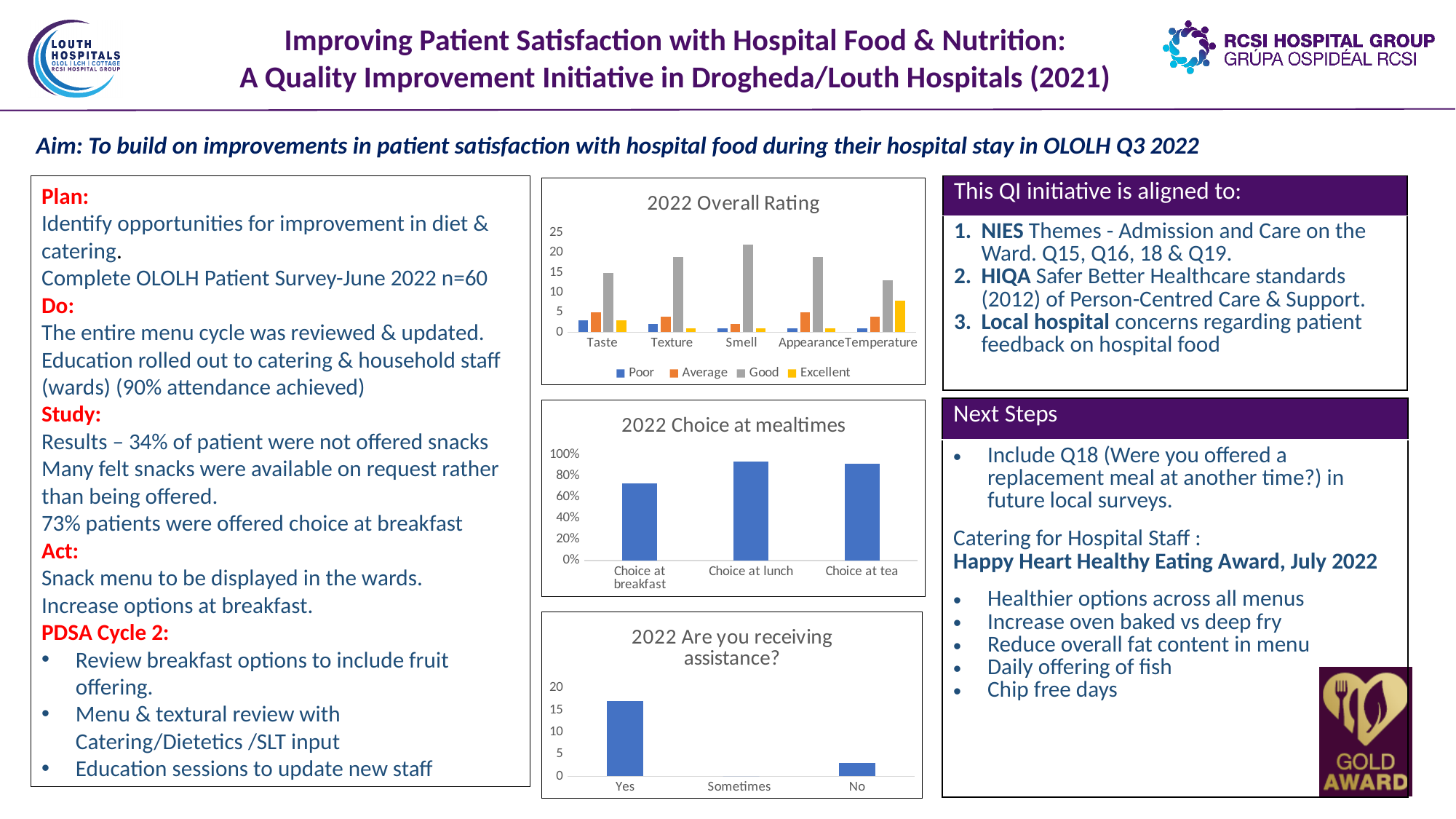
How many categories are shown on the x axis of the '2022 Overall Rating' chart? 5 In the '2022 Overall Rating' chart, which category has the tallest Excellent bar? Temperature In the '2022 Are you receiving assistance?' chart, is the value for Yes greater or less than 15? greater In the '2022 Choice at mealtimes' chart, which is larger: Choice at breakfast or Choice at lunch? Choice at lunch In the '2022 Are you receiving assistance?' chart, which category has the highest value? Yes In the '2022 Overall Rating' chart, which series has the tallest bar for Smell? Good In the '2022 Overall Rating' chart, is the Good value for Temperature greater or less than 15? less What kind of chart is the '2022 Overall Rating' chart? bar chart How many series does the legend of the '2022 Overall Rating' chart list? 4 In the '2022 Choice at mealtimes' chart, which category has the lowest value? Choice at breakfast In the '2022 Overall Rating' chart, is the Good value for Smell greater or less than 20? greater